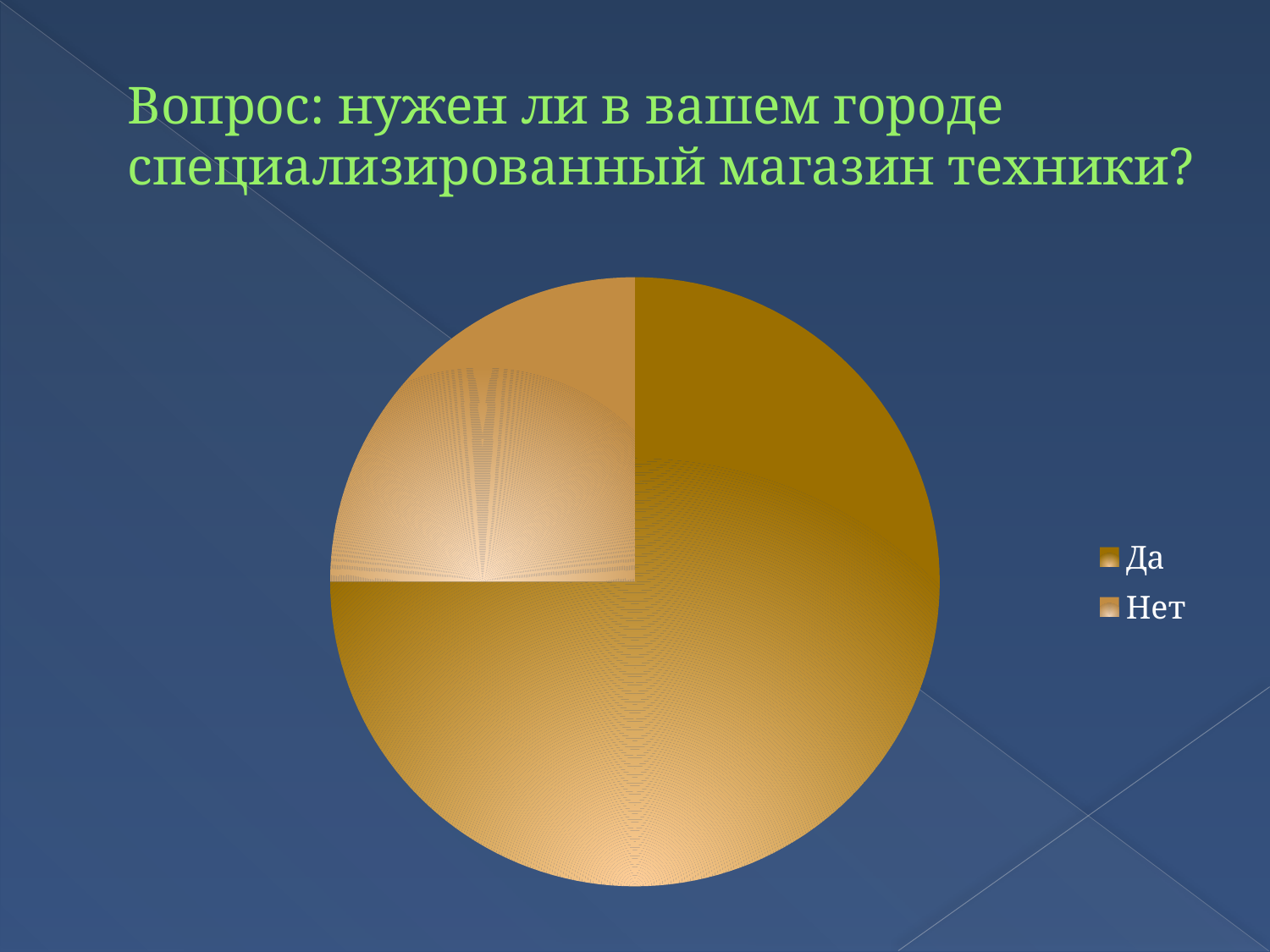
Which slice is larger, Да or Нет? Да Which category has the smallest slice of the pie? Нет What are the two legend entries of the pie chart? Да, Нет Which category has the largest slice of the pie? Да What kind of chart is shown on the slide? pie chart How many entries does the legend list? 2 What question is posed in the slide title above the chart? Вопрос: нужен ли в вашем городе специализированный магазин техники? How many slices does the pie chart have? 2 Does the Да slice take up more or less than half of the pie? more